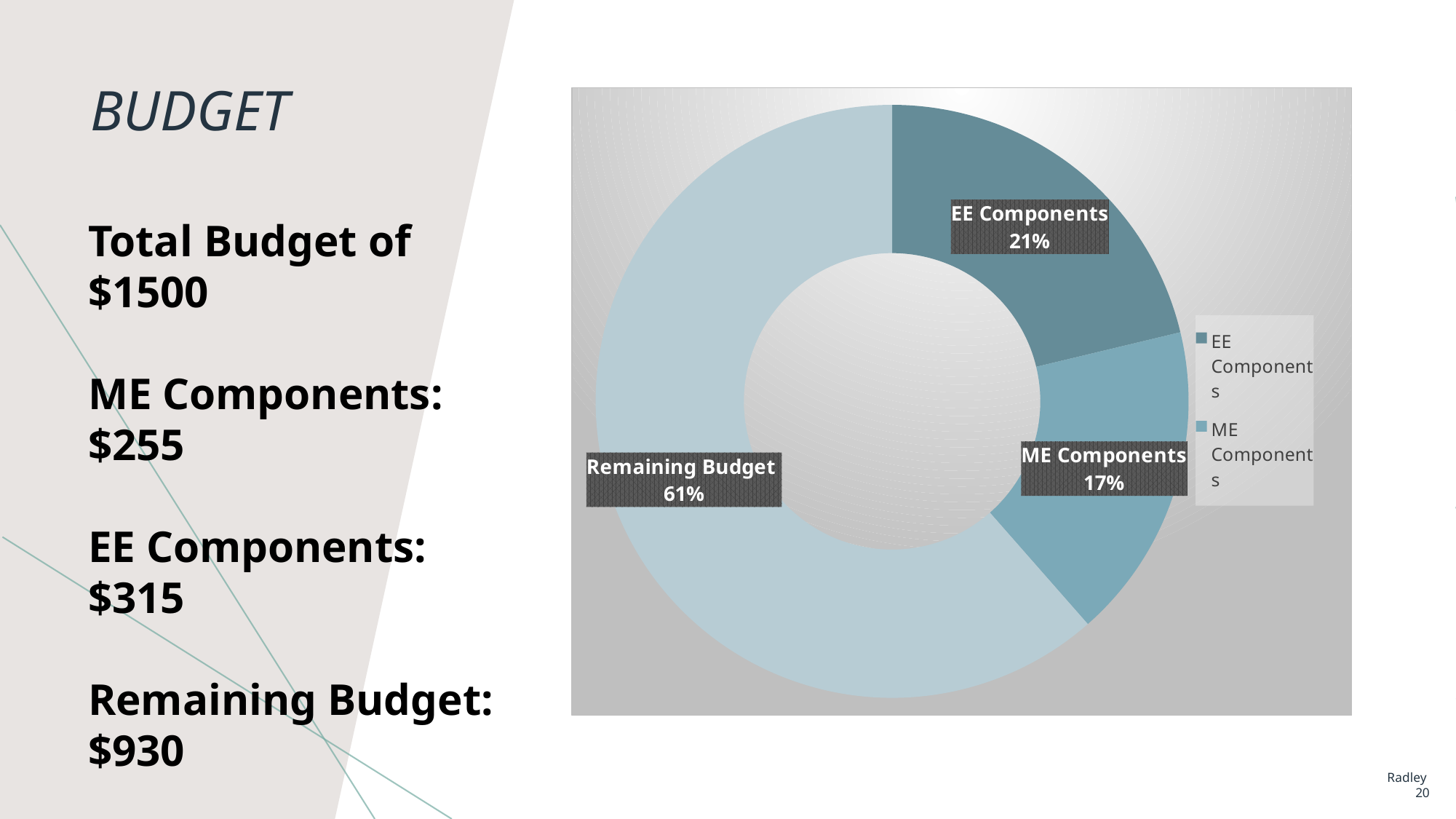
How many entries are visible in the chart's legend? 2 What is the difference in percentage points between EE Components and ME Components? 4% How many slices does the chart have? 3 What kind of chart is shown on the slide? doughnut chart What percentage is shown for ME Components? 17% What percentage is shown for EE Components? 21% Which is larger, the EE Components slice or the ME Components slice? EE Components Which slice of the chart is the largest? Remaining Budget What share of the chart does the Remaining Budget slice represent? 61% What is the difference in percentage points between Remaining Budget and EE Components? 40% Which slice of the chart is drawn in the darkest colour? EE Components Which slice of the chart is the smallest? ME Components